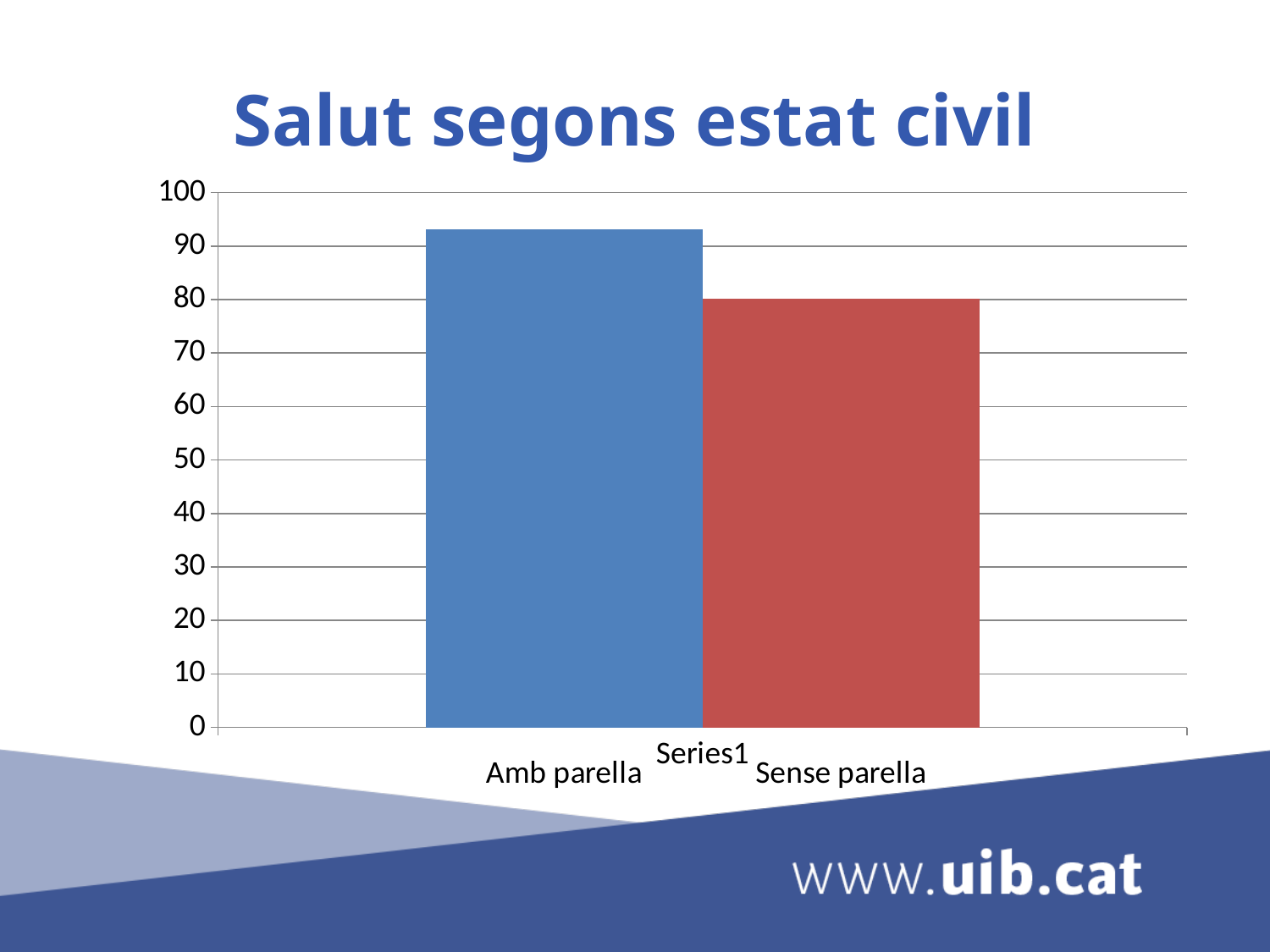
Which category has the lowest value? Sense parella What is the title of the chart? Salut segons estat civil Which category has the highest value? Amb parella What is the maximum value shown on the vertical axis? 100 Is the value for Amb parella greater or less than 100? less What colour is the bar for Sense parella? red Is the value for Amb parella greater or less than 90? greater Is the value for Sense parella greater or less than 90? less What kind of chart is shown on the slide? bar chart Which is larger, the value for Amb parella or the value for Sense parella? Amb parella How many bars are plotted in the chart? 2